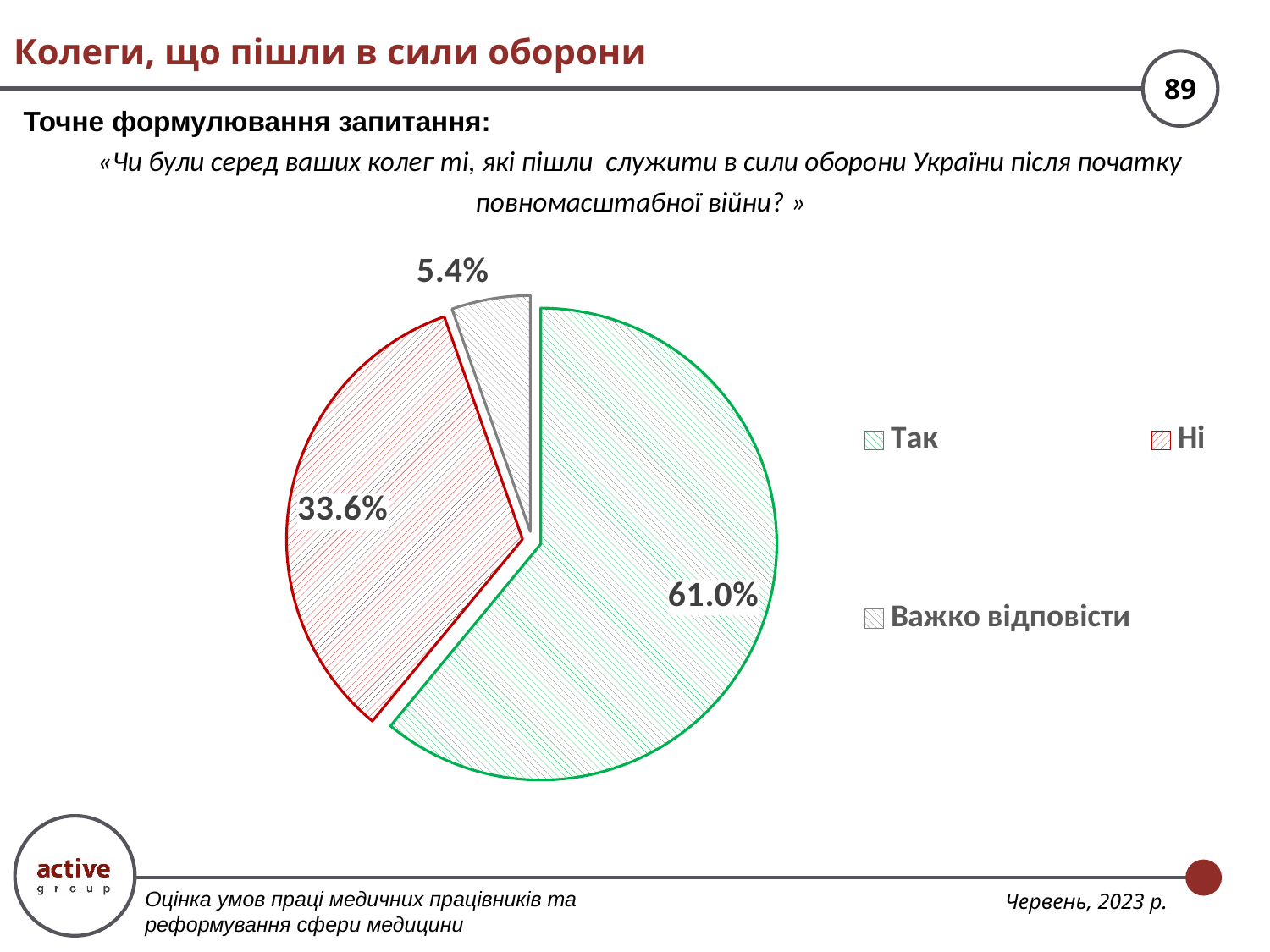
What share of the pie does the "Так" slice represent? 61.0% What is the title of the slide containing the chart? Колеги, що пішли в сили оборони Which category has the largest slice of the pie? Так What kind of chart is shown on the slide? Pie chart What is the difference between the "Так" and "Ні" values? 27.4% Which category has the smallest slice of the pie? Важко відповісти How many categories are shown in the pie chart? 3 What is the difference between the "Ні" and "Важко відповісти" values? 28.2% Which legend entry is shown with a red hatched pattern? Ні What is the value shown for "Ні"? 33.6% Which is larger, the value for "Ні" or the value for "Важко відповісти"? Ні What is the value shown for "Важко відповісти"? 5.4%